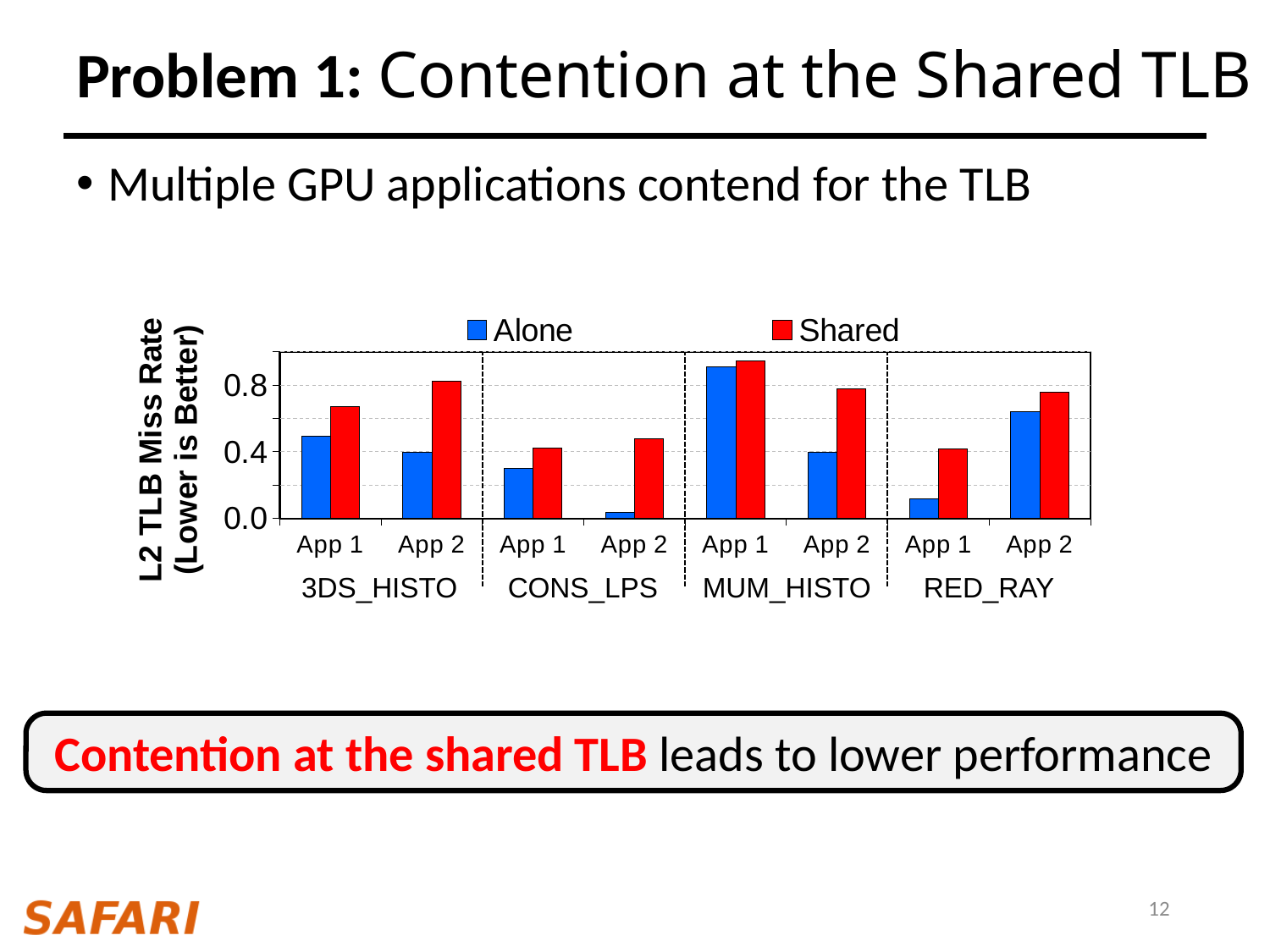
For RED_RAY App 1, which is larger: the Alone value or the Shared value? Shared For CONS_LPS App 2, which is larger: the Alone value or the Shared value? Shared Is the Alone value for MUM_HISTO App 1 greater or less than 0.8? greater How many workload groups are shown along the x axis of the chart? 4 Which application has the lowest Alone L2 TLB miss rate? CONS_LPS App 2 What kind of chart is shown on the slide? bar chart What is the y-axis label of the chart? L2 TLB Miss Rate (Lower is Better) Which application has the highest Shared L2 TLB miss rate? MUM_HISTO App 1 Is the Shared value for 3DS_HISTO App 1 greater or less than 0.4? greater How many series does the chart legend list? 2 Is the Alone value for RED_RAY App 1 greater or less than 0.4? less What are the two series named in the chart legend? Alone and Shared